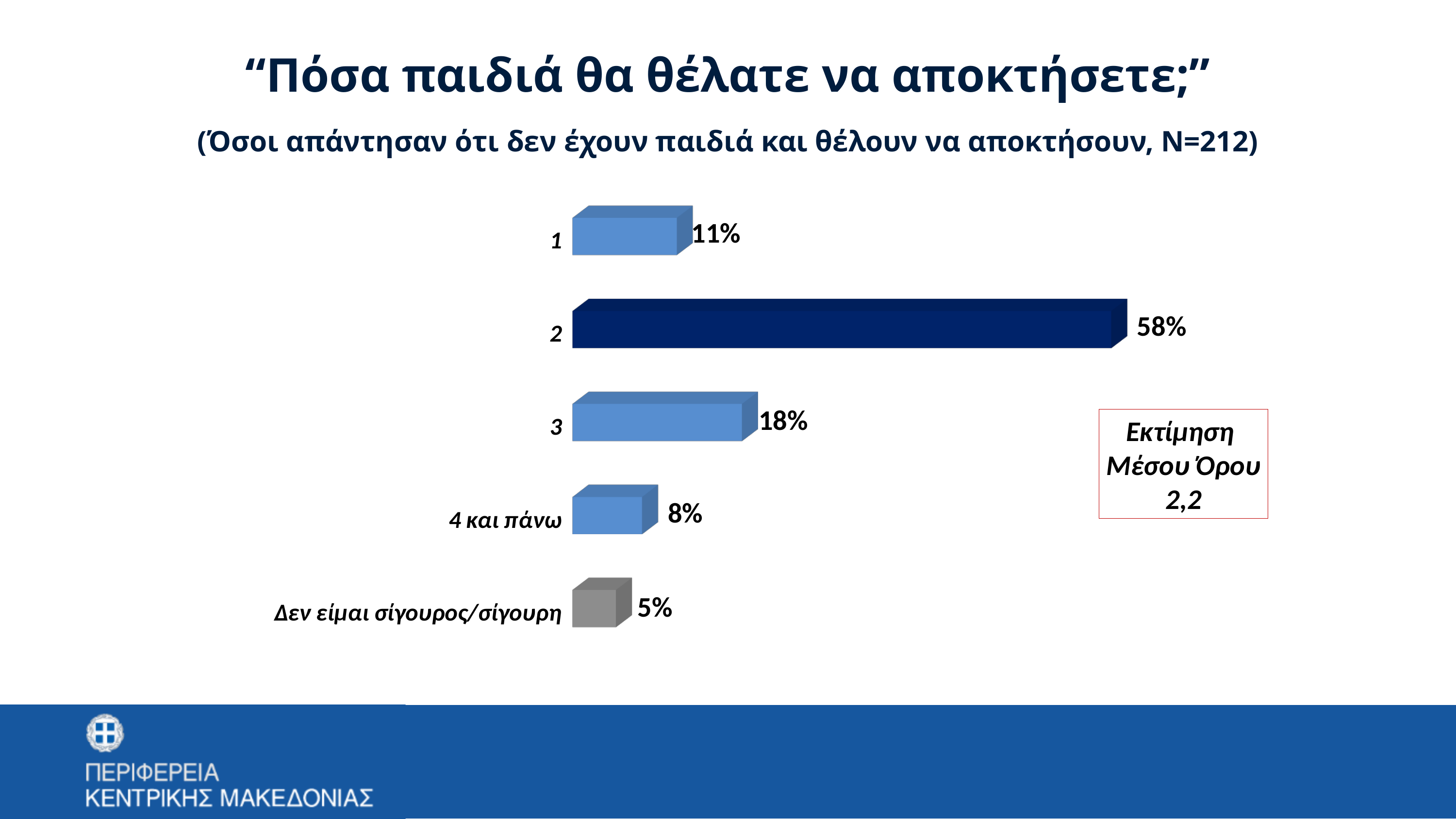
What estimated mean (Εκτίμηση Μέσου Όρου) is shown in the box next to the chart? 2,2 What percentage of respondents said they would like to have 2 children? 58% What is the difference between the values for "1" and "4 και πάνω"? 3% Which category has the lowest value? Δεν είμαι σίγουρος/σίγουρη How many categories are shown in the chart? 5 What kind of chart is shown on the slide? Bar chart What is the value for the category "4 και πάνω"? 8% What percentage answered "Δεν είμαι σίγουρος/σίγουρη"? 5% Which category has the highest value? 2 What is the value for the category "1"? 11% Which is larger, the value for "3" or the value for "1"? 3 What is the difference between the values for "2" and "3"? 40%